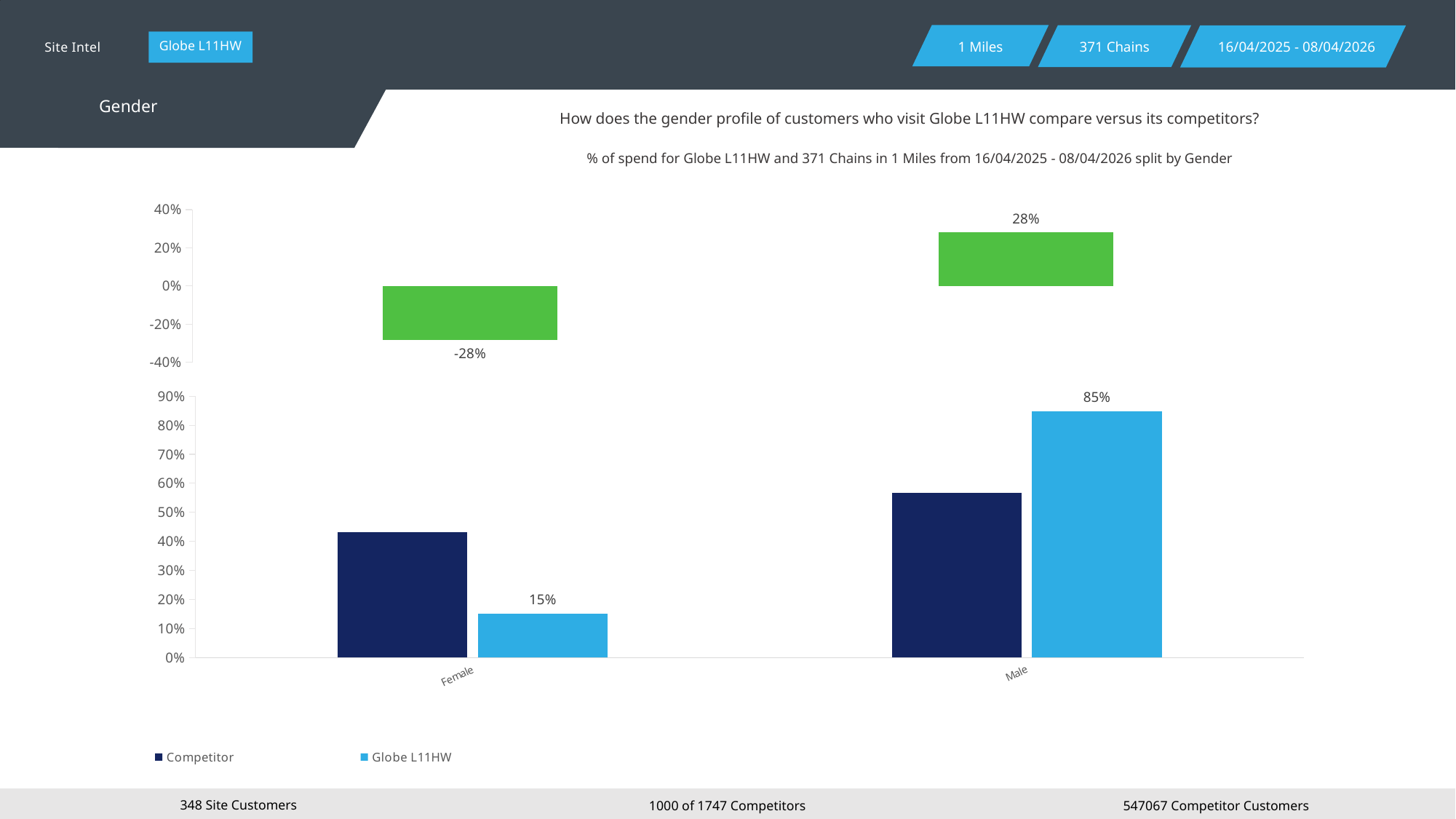
In the bottom chart, which category has the higher value for Globe L11HW, Female or Male? Male In the top chart, what is the value shown for the Female category? -28% In the bottom chart, what is the difference between the Globe L11HW values for Male and Female? 70% In the top chart, what is the value shown for the Male category? 28% How many categories are shown on the x axis of the bottom chart? 2 What kind of chart is the bottom chart? Bar chart How many series does the legend of the bottom chart list? 2 In the bottom chart, is the Competitor value for Female greater or less than 50%? less In the bottom chart, what is the value for Globe L11HW in the Female category? 15% In the bottom chart, for the Female category, which series has the larger value, Competitor or Globe L11HW? Competitor In the bottom chart, is the Competitor value for Male greater or less than 50%? greater In the bottom chart, what is the value for Globe L11HW in the Male category? 85%